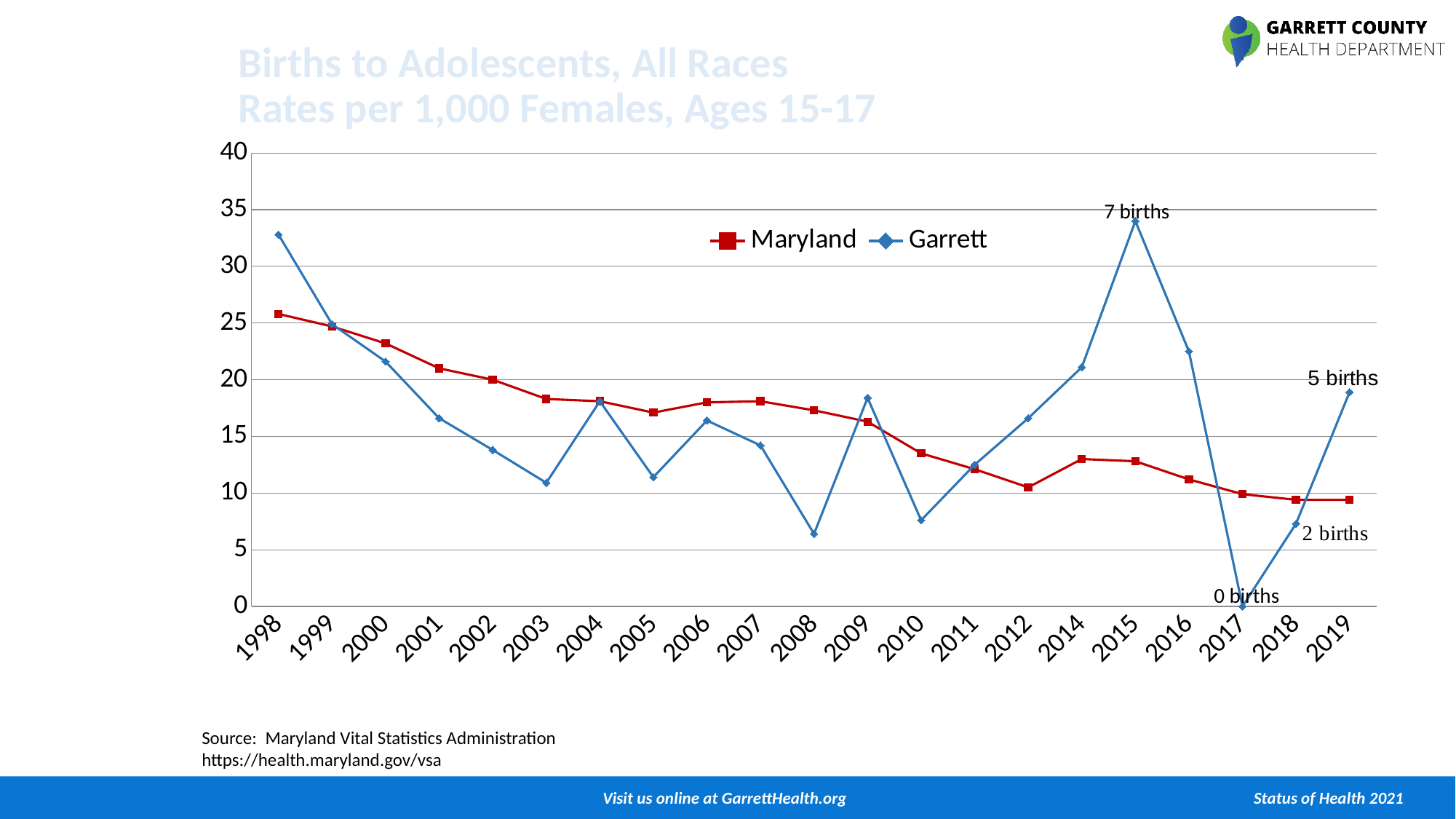
In which year does the Garrett series reach its lowest value? 2017 How many years are shown along the x axis? 21 What annotation is printed next to the Garrett point for 2015? 7 births In which year does the Garrett series reach its highest value? 2015 In which year is the Maryland rate highest? 1998 In 2003, which series has the higher rate, Maryland or Garrett? Maryland What is the Garrett rate in 2017? 0 How many series does the legend list? 2 Is the Garrett value for 2008 greater or less than 10? less Is the Maryland value for 2019 greater or less than 10? less Is the Garrett value for 1998 greater or less than 30? greater What kind of chart is shown on the slide? line chart